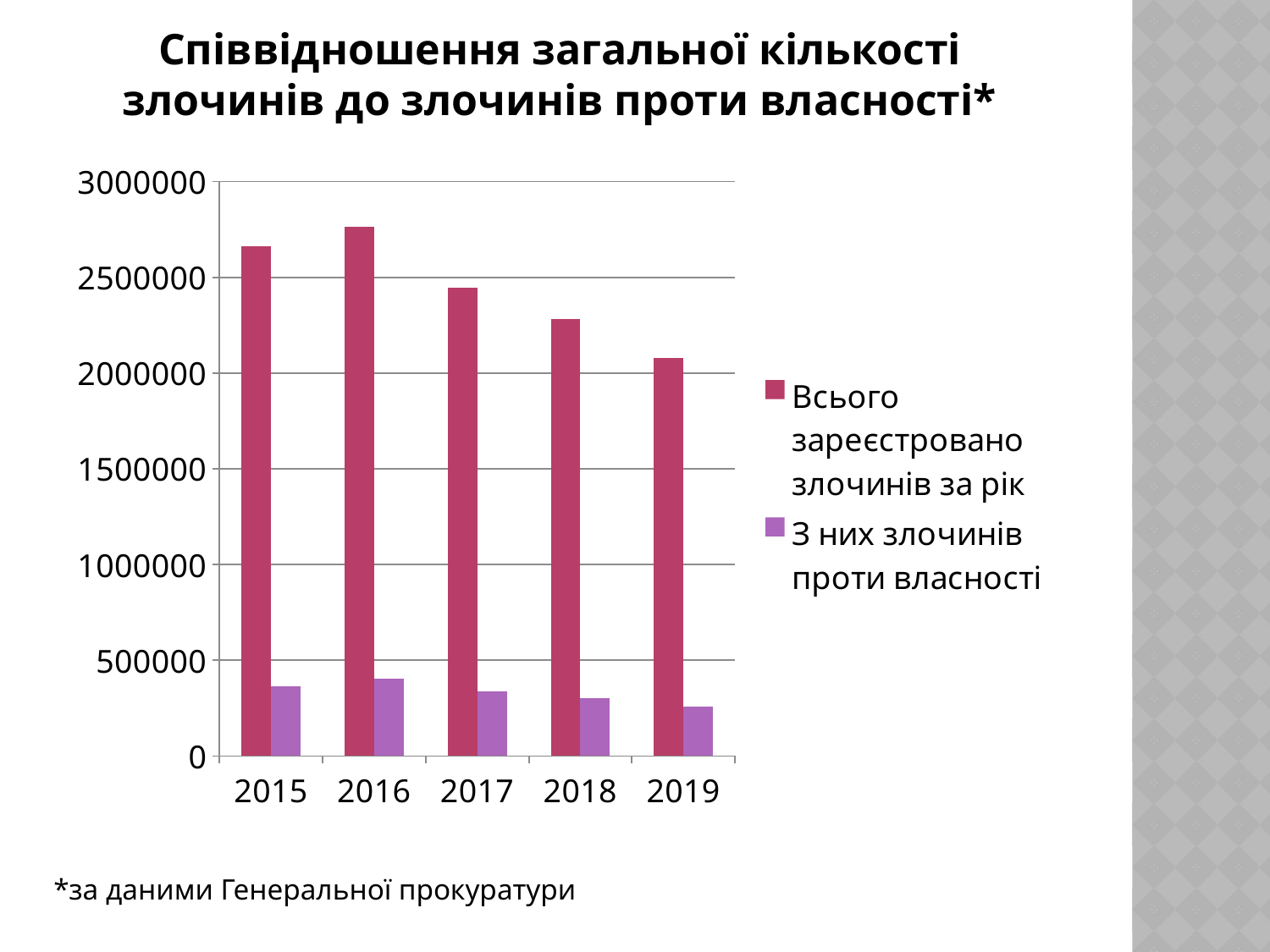
In which year is the value for "З них злочинів проти власності" highest? 2016 In which year is the value for "Всього зареєстровано злочинів за рік" highest? 2016 What kind of chart is shown on the slide? bar chart Which year has the larger value for "Всього зареєстровано злочинів за рік", 2017 or 2018? 2017 In which year is the value for "З них злочинів проти власності" lowest? 2019 Is the value for "Всього зареєстровано злочинів за рік" in 2015 greater or less than 2500000? greater From 2016 to 2019, do the values for "Всього зареєстровано злочинів за рік" rise or fall? fall Is the value for "З них злочинів проти власності" in 2016 greater or less than 500000? less Is the value for "Всього зареєстровано злочинів за рік" in 2018 greater or less than 2500000? less In which year is the value for "Всього зареєстровано злочинів за рік" lowest? 2019 How many years are shown on the x axis? 5 How many series does the legend list? 2